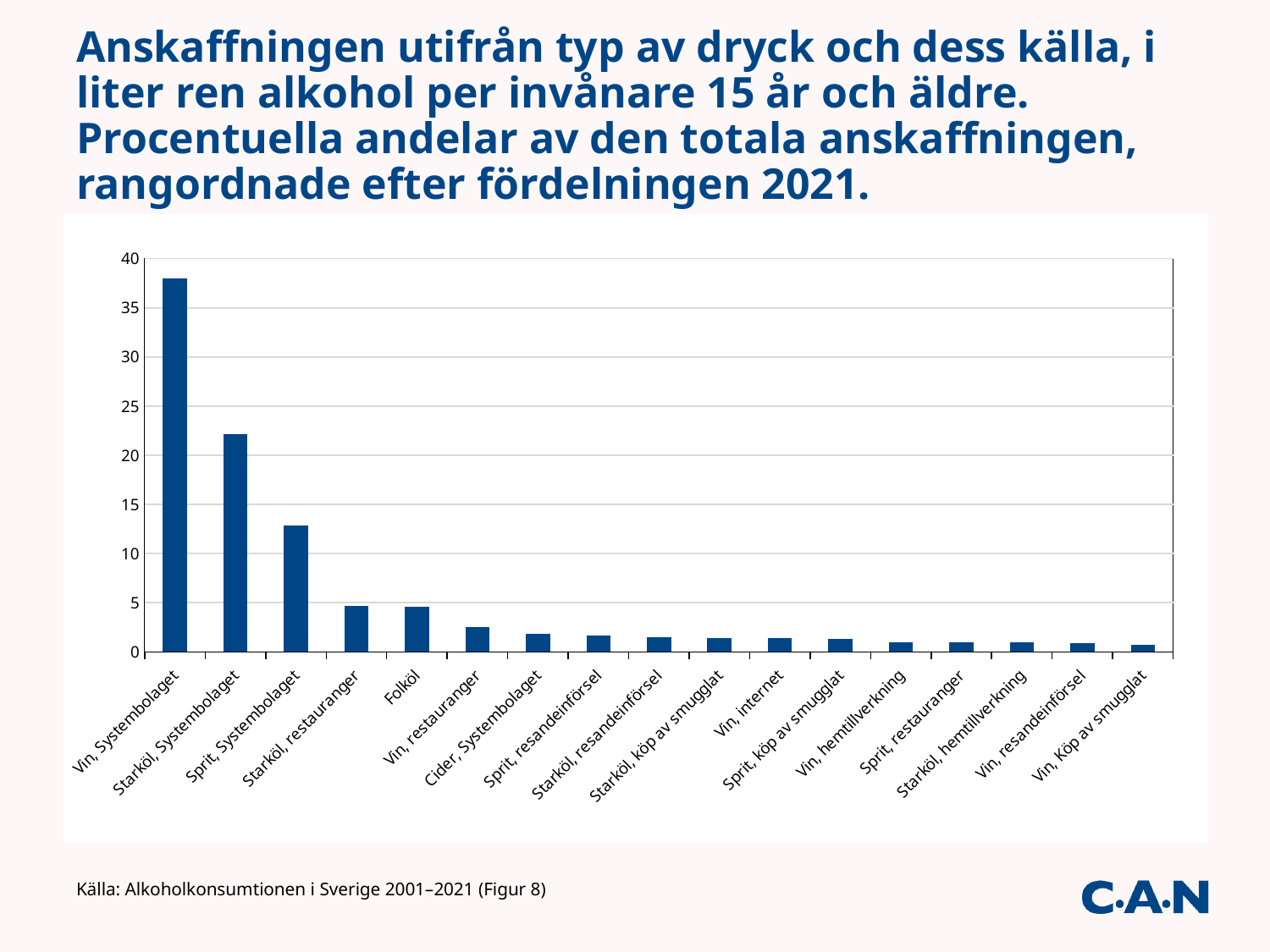
Is the value for Sprit, Systembolaget greater or less than 10? greater Which category has the lowest value? Vin, Köp av smugglat Do the values rise or fall moving from left to right along the x axis? fall Is the value for Vin, restauranger greater or less than 5? less Which category has the highest value? Vin, Systembolaget Is the value for Vin, Systembolaget greater or less than 35? greater What kind of chart is shown on the slide? bar chart What source is cited below the chart? Alkoholkonsumtionen i Sverige 2001–2021 (Figur 8) Which is larger, the value for Starköl, Systembolaget or the value for Sprit, Systembolaget? Starköl, Systembolaget How many categories are plotted on the x axis? 17